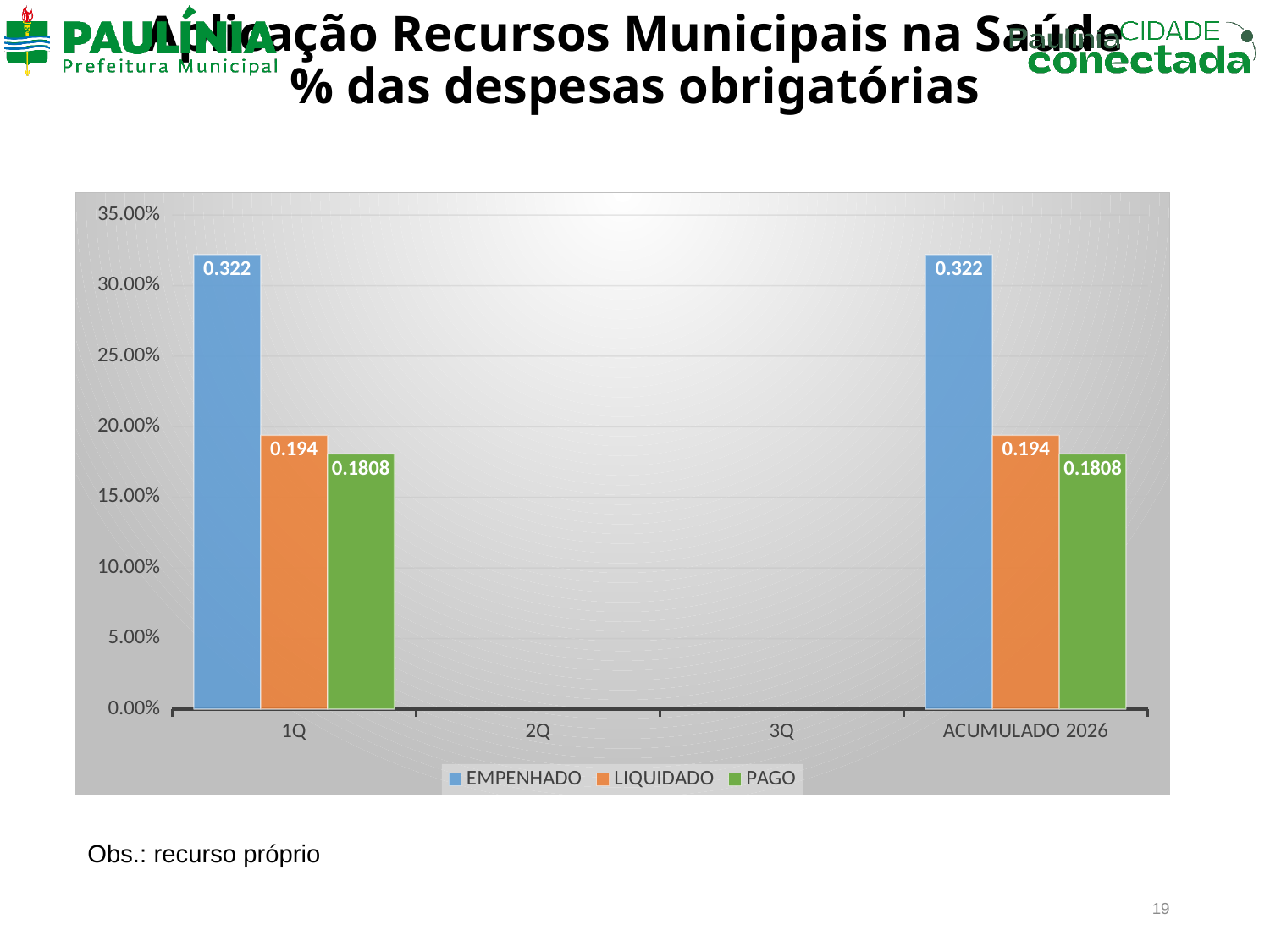
What kind of chart is shown on the slide? bar chart How many series does the legend list? 3 What is the EMPENHADO value for 1Q? 0.322 Which is larger for ACUMULADO 2026, LIQUIDADO or PAGO? LIQUIDADO Which series has the lowest value for ACUMULADO 2026? PAGO How many categories are shown on the x axis? 4 Which colour represents the PAGO series in the legend? green Which series has the highest value for 1Q? EMPENHADO What is the LIQUIDADO value for ACUMULADO 2026? 0.194 What is the PAGO value for 1Q? 0.1808 Is the EMPENHADO bar for ACUMULADO 2026 greater or less than 30.00%? greater What is the difference between the EMPENHADO and LIQUIDADO values for 1Q? 0.128